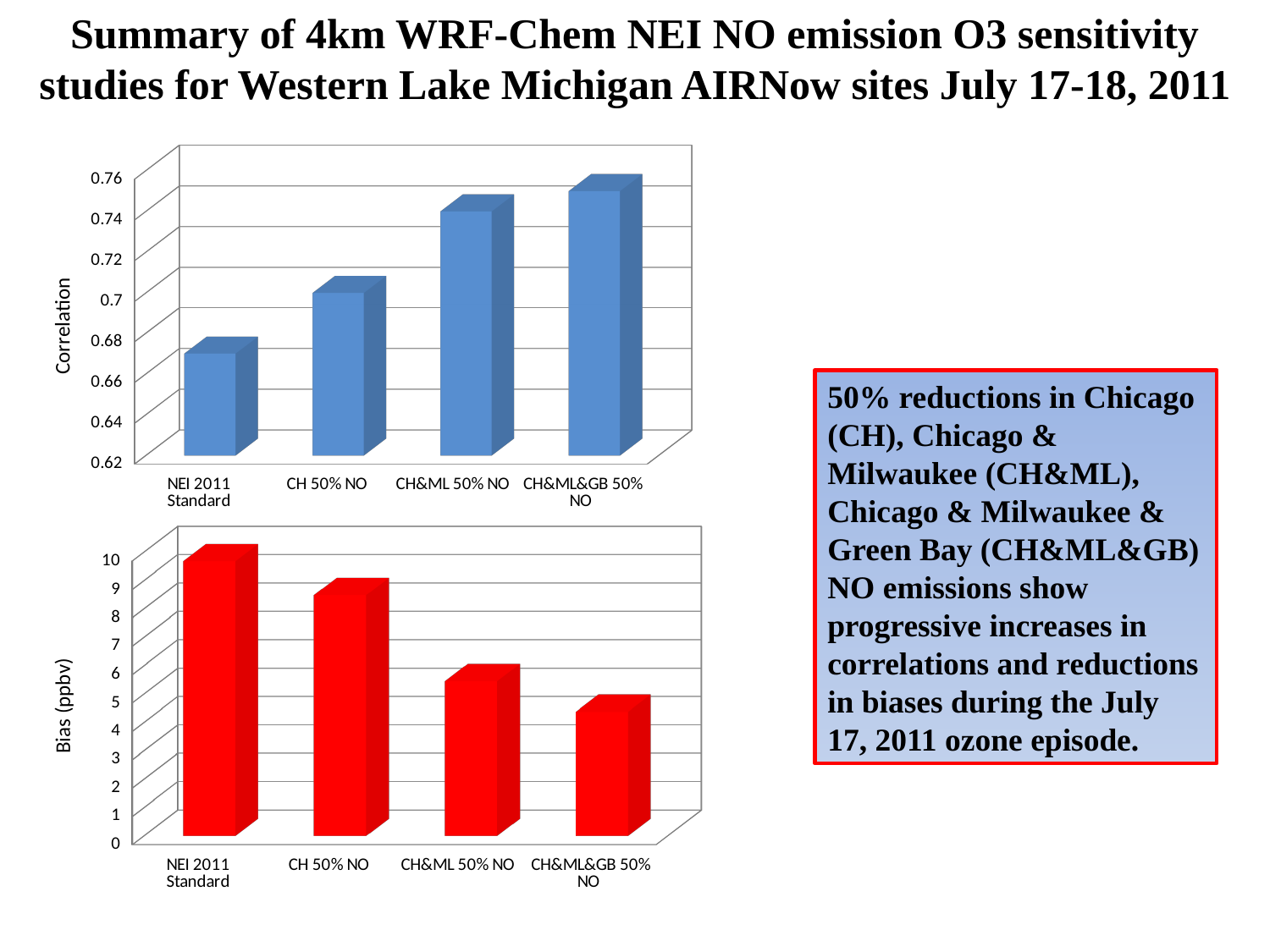
In the top chart (Correlation), is the value for CH&ML 50% NO greater or less than 0.72? greater In the bottom chart (Bias (ppbv)), which category has the lowest bias? CH&ML&GB 50% NO In the bottom chart (Bias (ppbv)), is the value for CH&ML&GB 50% NO greater or less than 5? less In the top chart (Correlation), is the value for NEI 2011 Standard greater or less than 0.70? less Do the values in the top chart (Correlation) rise or fall from left to right across the categories? rise In the top chart (Correlation), which category has the highest correlation? CH&ML&GB 50% NO In the bottom chart (Bias (ppbv)), which category has the highest bias? NEI 2011 Standard How many categories are shown on the bottom chart (Bias (ppbv))? 4 What kind of chart is the top chart (Correlation)? bar chart In the bottom chart (Bias (ppbv)), which is larger, the bias for CH 50% NO or for CH&ML 50% NO? CH 50% NO In the top chart (Correlation), which category has the lowest correlation? NEI 2011 Standard